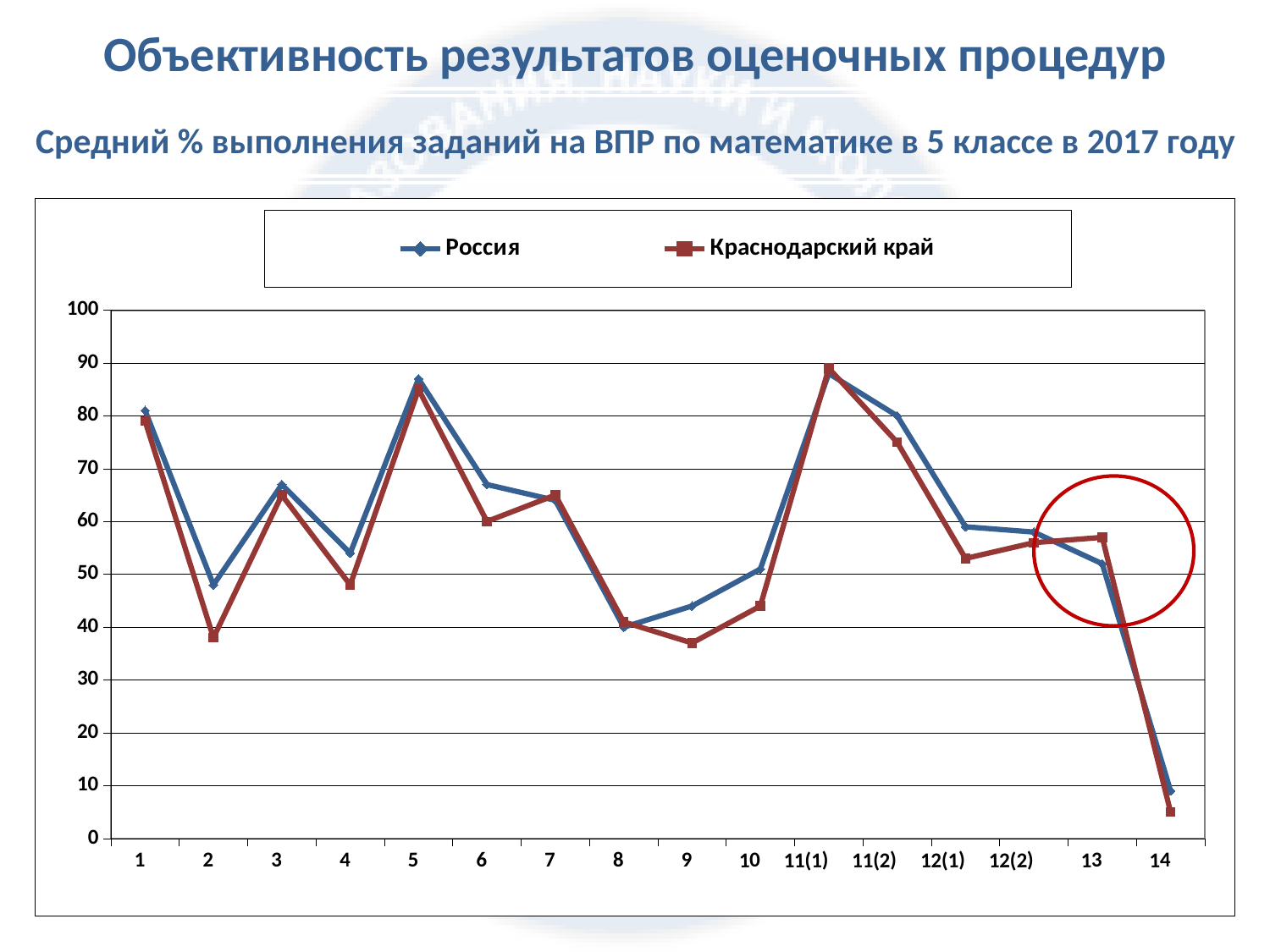
At category 13, which series has the larger value, Россия or Краснодарский край? Краснодарский край For which category is the value for Краснодарский край highest? 11(1) How many categories are shown on the x axis? 16 What kind of chart is shown on the slide? line chart How many series does the legend list? 2 For which category is the value for Россия lowest? 14 Is the value for Краснодарский край at category 9 greater or less than 40? less Which two series are listed in the legend? Россия and Краснодарский край Is the value for Краснодарский край at category 11(2) greater or less than 70? greater At category 2, which series has the larger value, Россия or Краснодарский край? Россия Is the value for Россия at category 6 greater or less than 60? greater For which category is the value for Краснодарский край lowest? 14